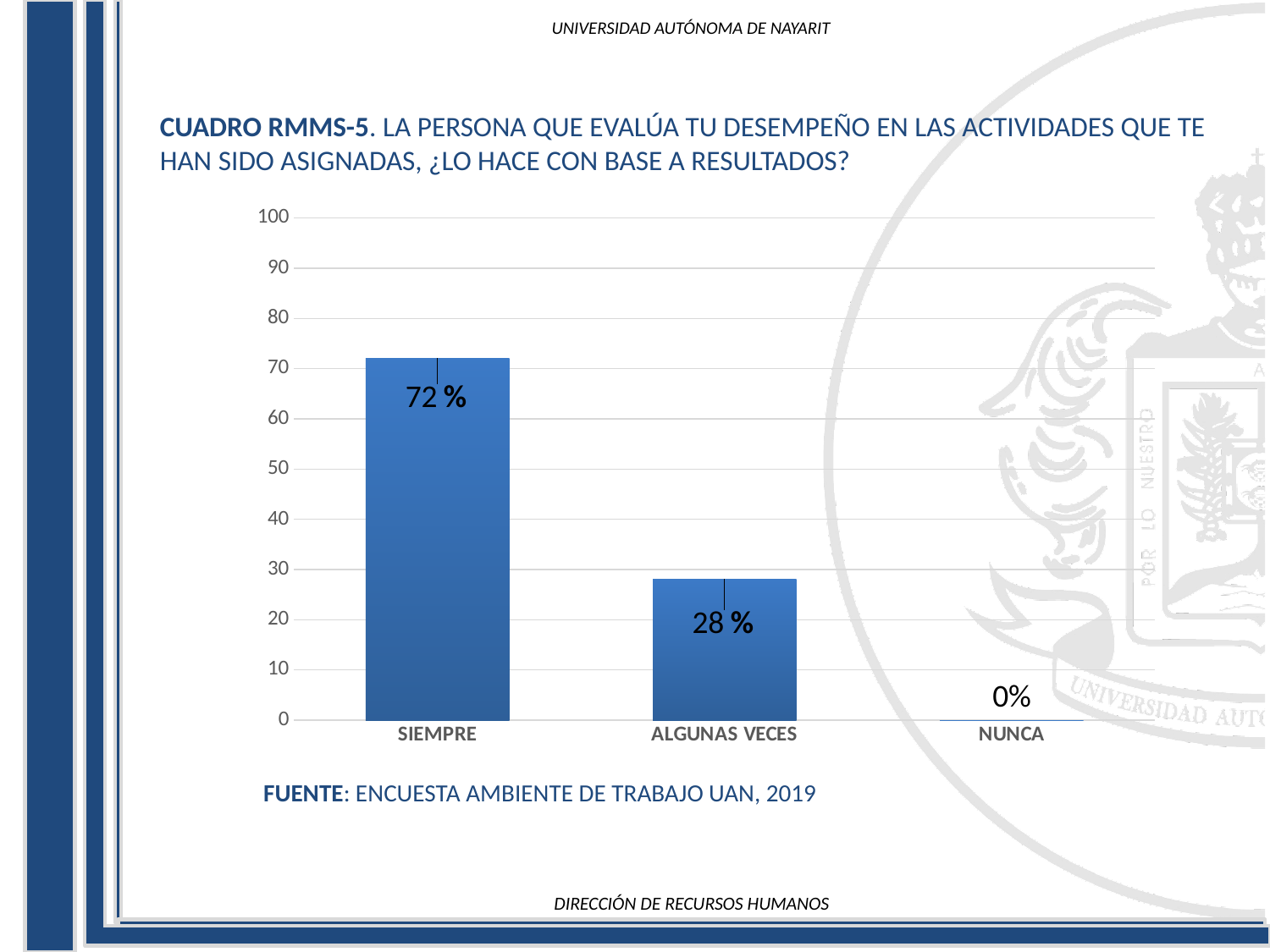
What is the value for NUNCA? 0% What is the source cited below the chart? ENCUESTA AMBIENTE DE TRABAJO UAN, 2019 What kind of chart is shown on the slide? bar chart Which category has the highest value? SIEMPRE Is the value for ALGUNAS VECES greater or less than 30? less Do the values rise or fall from left to right along the x axis? fall Which category has the lowest value? NUNCA What is the value for SIEMPRE? 72 % How many categories are shown on the x axis? 3 What is the difference between the values for SIEMPRE and ALGUNAS VECES? 44 % What is the value for ALGUNAS VECES? 28 % Which is larger, the value for SIEMPRE or the value for ALGUNAS VECES? SIEMPRE